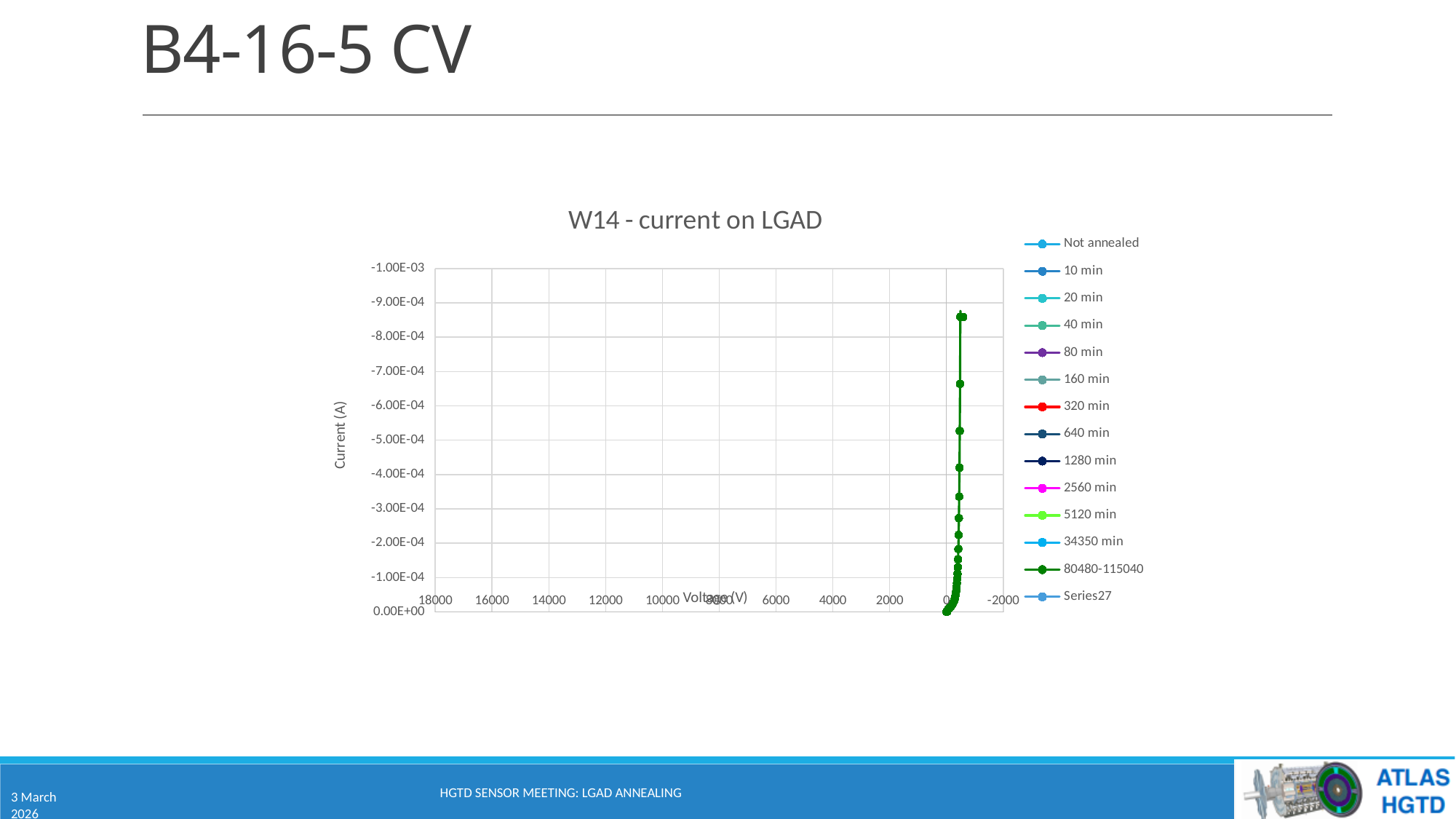
Is the largest-magnitude current value plotted for the 80480-115040 series greater or less than 9.00E-04 in magnitude? less Which series is the only one with visibly plotted data points on the chart? 80480-115040 How many series have data points visibly plotted on the chart? 1 What kind of chart is shown on the slide? line chart How many series does the chart's legend list? 14 What is the title of the chart? W14 - current on LGAD Is the largest-magnitude current value plotted for the 80480-115040 series greater or less than 8.00E-04 in magnitude? greater